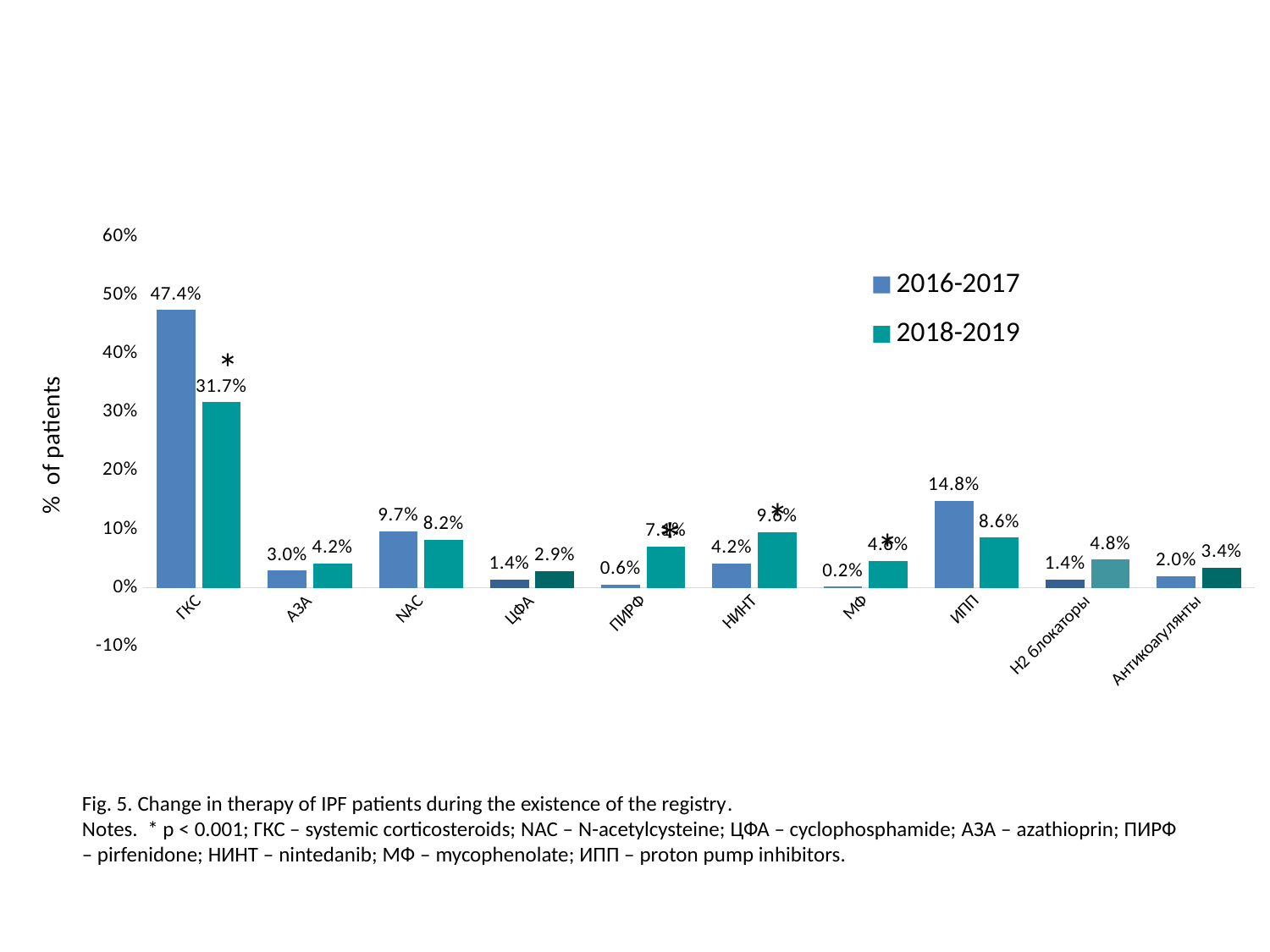
How many therapy categories are shown on the x axis? 10 What is the value for ГКС in 2018-2019? 31.7% Which is larger for NAC: the 2016-2017 value or the 2018-2019 value? 2016-2017 What is the value for ГКС in 2016-2017? 47.4% What is the value for Н2 блокаторы in 2018-2019? 4.8% What is the difference between the 2016-2017 and 2018-2019 values for ГКС? 15.7% What kind of chart is shown on the slide? bar chart What is the value for ИПП in 2016-2017? 14.8% Which category has the highest value in the 2016-2017 series? ГКС Which category has the lowest value in the 2016-2017 series? МФ How many series does the legend list? 2 What is the label of the y axis? % of patients